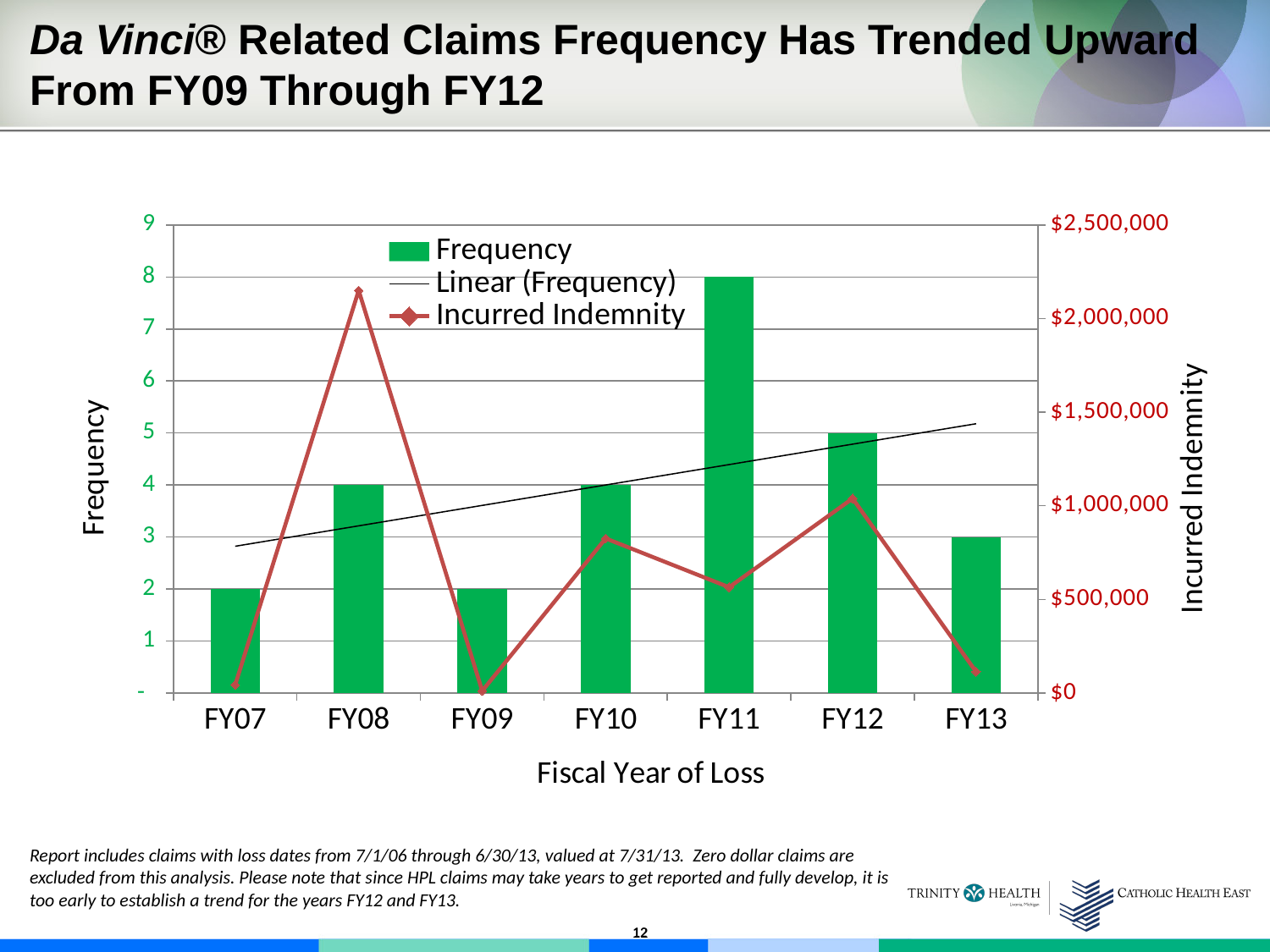
How many series does the legend list? 3 What is the difference in Frequency between FY11 and FY12? 3 Is the Incurred Indemnity for FY08 greater or less than $2,000,000? greater Does the Linear (Frequency) trend line rise or fall from FY07 to FY13? rise How many fiscal years are shown on the x axis? 7 What is the Frequency value for FY11? 8 Which has the larger Frequency, FY10 or FY13? FY10 Is the Incurred Indemnity for FY13 greater or less than $500,000? less Which fiscal year has the highest Frequency? FY11 What is the Frequency value for FY12? 5 Which fiscal year has the highest Incurred Indemnity? FY08 What kind of chart is shown on the slide? bar and line chart